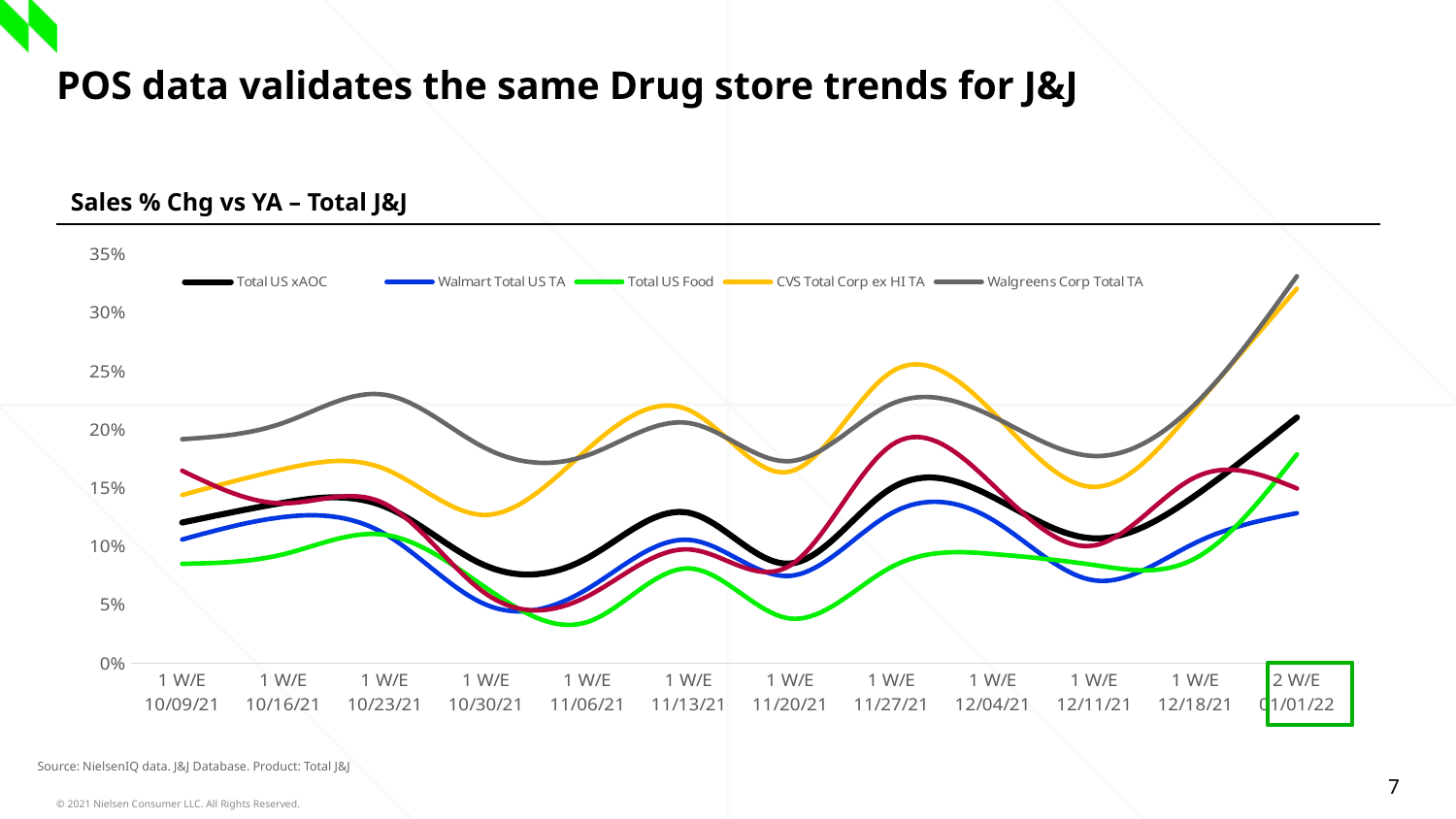
Is the value for Total US Food at 1 W/E 11/06/21 greater or less than 5%? less What is the title of the chart? Sales % Chg vs YA – Total J&J Which series is shown in yellow in the chart legend? CVS Total Corp ex HI TA What kind of chart is shown on the slide? Line chart At 1 W/E 11/27/21, which is larger: Walgreens Corp Total TA or Walmart Total US TA? Walgreens Corp Total TA Which series has the highest value at 1 W/E 10/09/21? Walgreens Corp Total TA How many series does the chart legend list? 5 Is the value for Total US xAOC at 1 W/E 10/30/21 greater or less than 10%? less Is the value for Walgreens Corp Total TA at 2 W/E 01/01/22 greater or less than 30%? greater Which series has the lowest value at 1 W/E 11/06/21? Total US Food How many time periods are shown along the x axis of the chart? 12